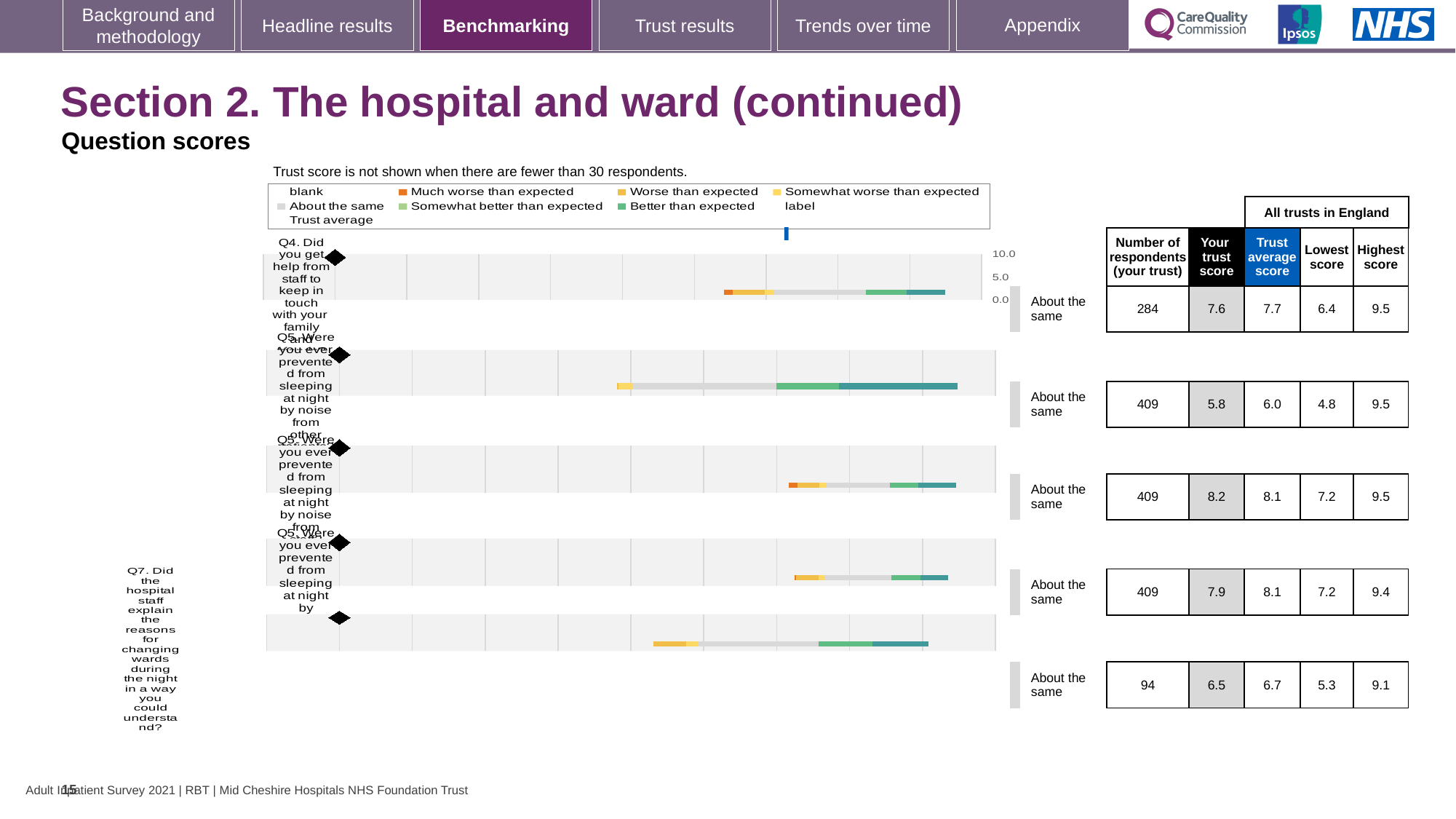
How many question bars are plotted in the chart? 5 Is the trust score for Q4 greater or less than 5.0? greater For Q4, which is larger: this trust's score or the trust average score? Trust average score What kind of chart is used to show the question scores on this slide? bar chart How many respondents answered Q4 for this trust? 284 What is the trust score for Q4 (help from staff to keep in touch with family and friends)? 7.6 What is the difference between the trust average score and this trust's score for Q4? 0.1 What is the lowest 'Your trust score' value shown for any question on this slide? 5.8 What is the trust score for Q7 (explaining reasons for changing wards during the night)? 6.5 What is the highest score among all trusts in England for Q7? 9.1 What is the trust average score for Q4? 7.7 What benchmark category is shown for Q4? About the same